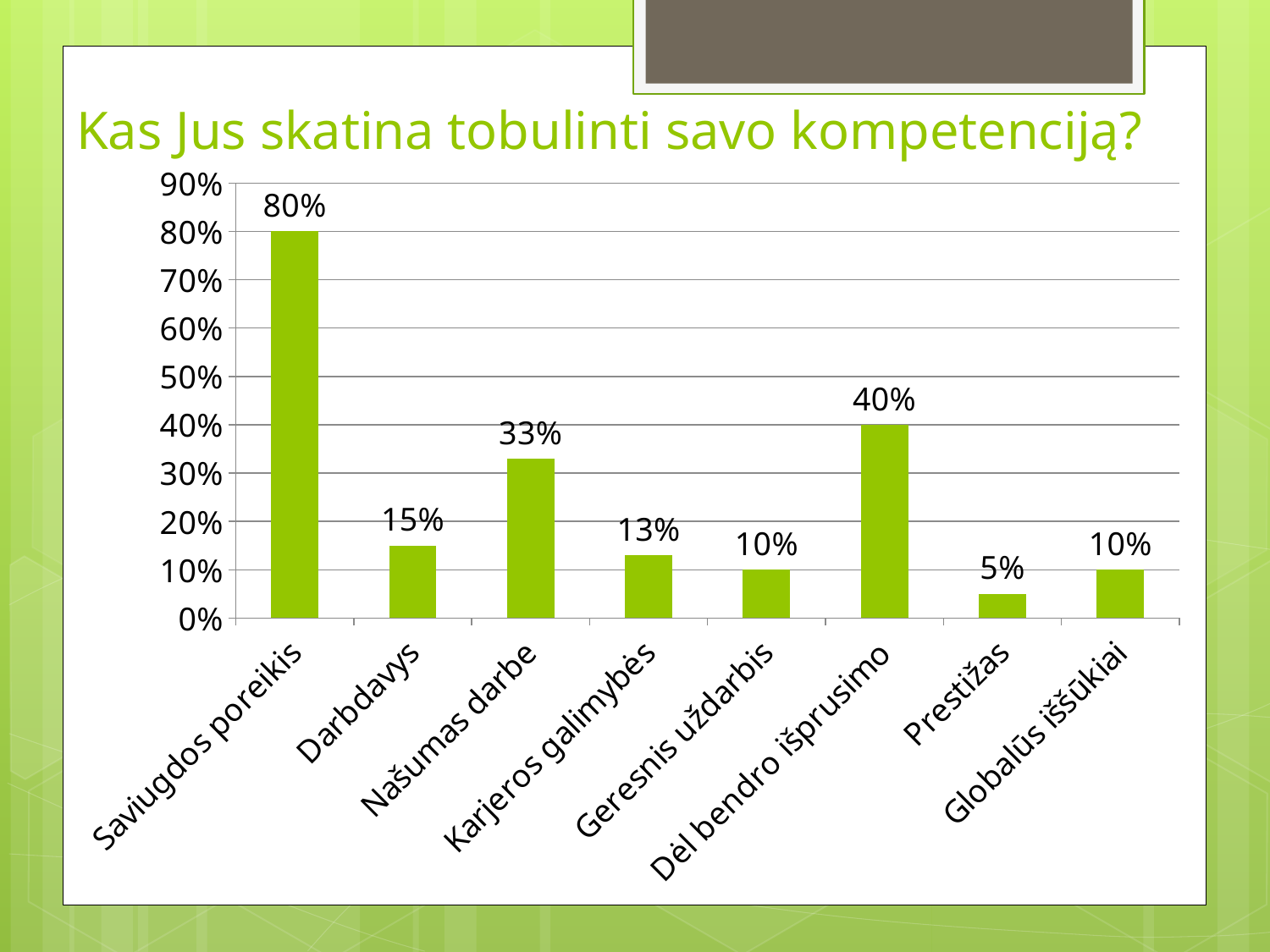
Which is larger, the value for Našumas darbe or the value for Darbdavys? Našumas darbe How many categories are shown on the x axis? 8 What is the difference between the values for Darbdavys and Karjeros galimybės? 2% What is the value for Dėl bendro išprusimo? 40% What is the value for Saviugdos poreikis? 80% What is the title of the slide? Kas Jus skatina tobulinti savo kompetenciją? What is the difference between the values for Saviugdos poreikis and Dėl bendro išprusimo? 40% What kind of chart is shown on the slide? bar chart Which category has the lowest value? Prestižas Which category has the highest value? Saviugdos poreikis What is the value for Našumas darbe? 33% Is the value for Dėl bendro išprusimo greater or less than 30%? greater